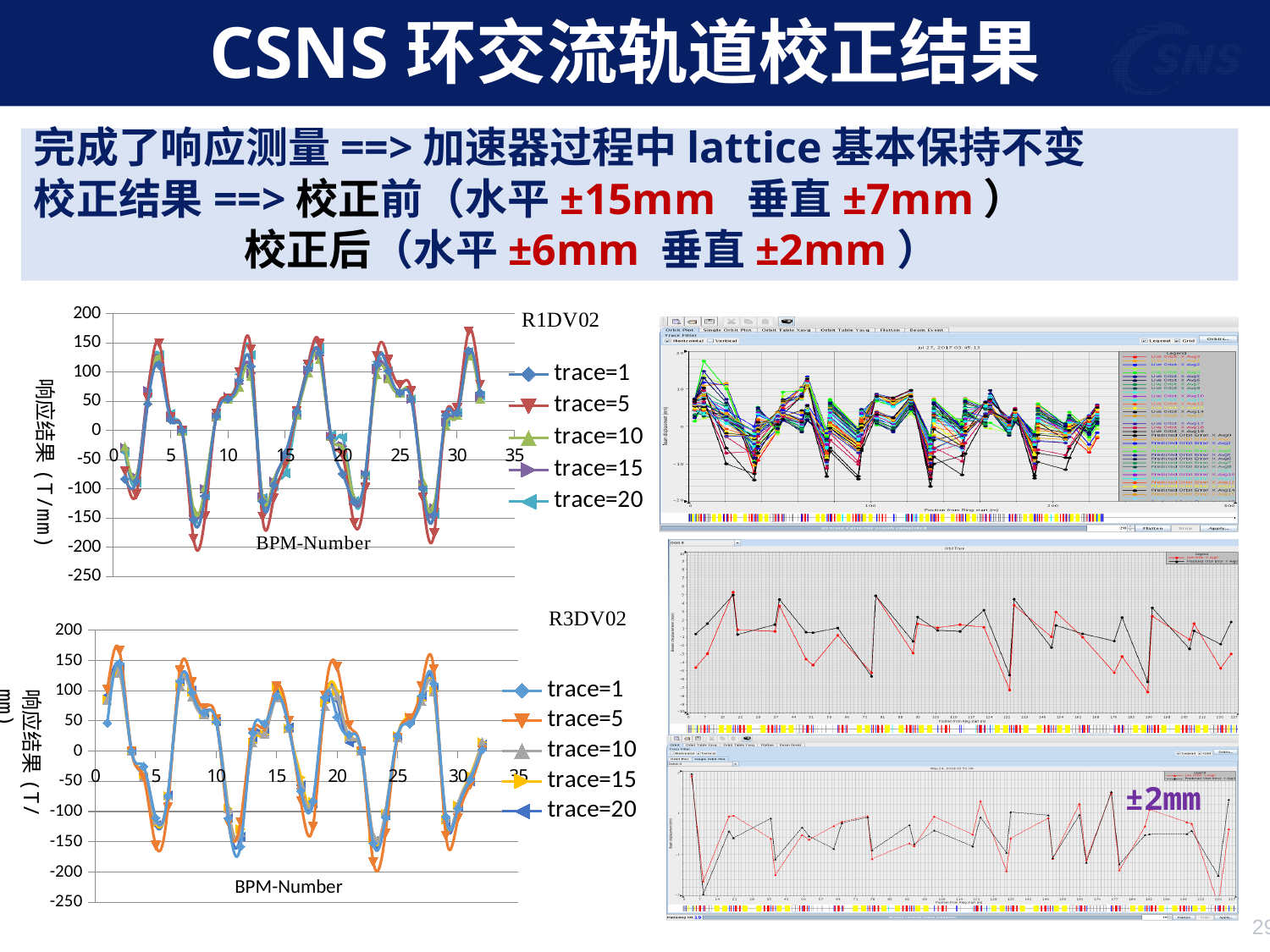
What are the legend entries of the R1DV02 chart? trace=1, trace=5, trace=10, trace=15, trace=20 What is the largest x-axis tick value shown on the R1DV02 chart? 35 How many series does the legend of the R3DV02 chart list? 5 In the R1DV02 chart, what is the highest value shown on the y axis? 200 In the R3DV02 chart, is the highest point of trace=5 near BPM 2 greater or less than 150? greater In the R3DV02 chart, is the lowest point of trace=5 near BPM 22 greater or less than -150? less In the R1DV02 chart, is the lowest point of trace=5 near BPM 7 greater or less than -150? less What kind of chart is the R1DV02 chart? line chart How many series does the legend of the R1DV02 chart list? 5 What is the x-axis label of the R3DV02 chart? BPM-Number In the R3DV02 chart, what is the lowest value shown on the y axis? -250